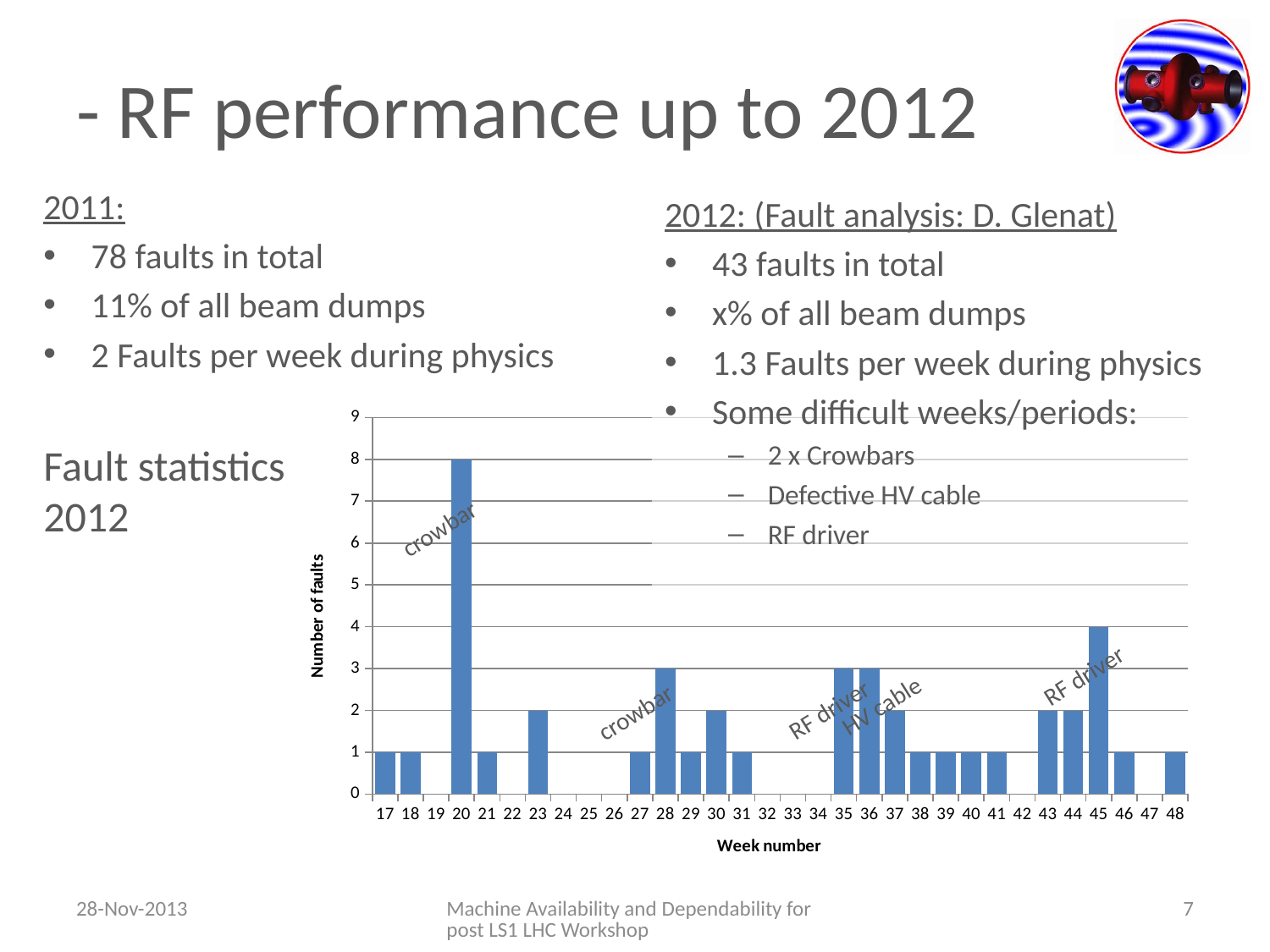
Which week number has the highest number of faults? 20 Is the number of faults for week 20 greater or less than 5? greater What is the difference in number of faults between week 20 and week 45? 4 Which has more faults, week 36 or week 38? week 36 How many faults are plotted for week 37? 2 How many faults are plotted for week 20? 8 What is the label of the vertical axis of the chart? Number of faults How many week numbers are shown on the x axis of the chart? 32 What is the label of the horizontal axis of the chart? Week number What type of chart is shown on the slide? bar chart How many faults are plotted for week 28? 3 How many faults are plotted for week 45? 4